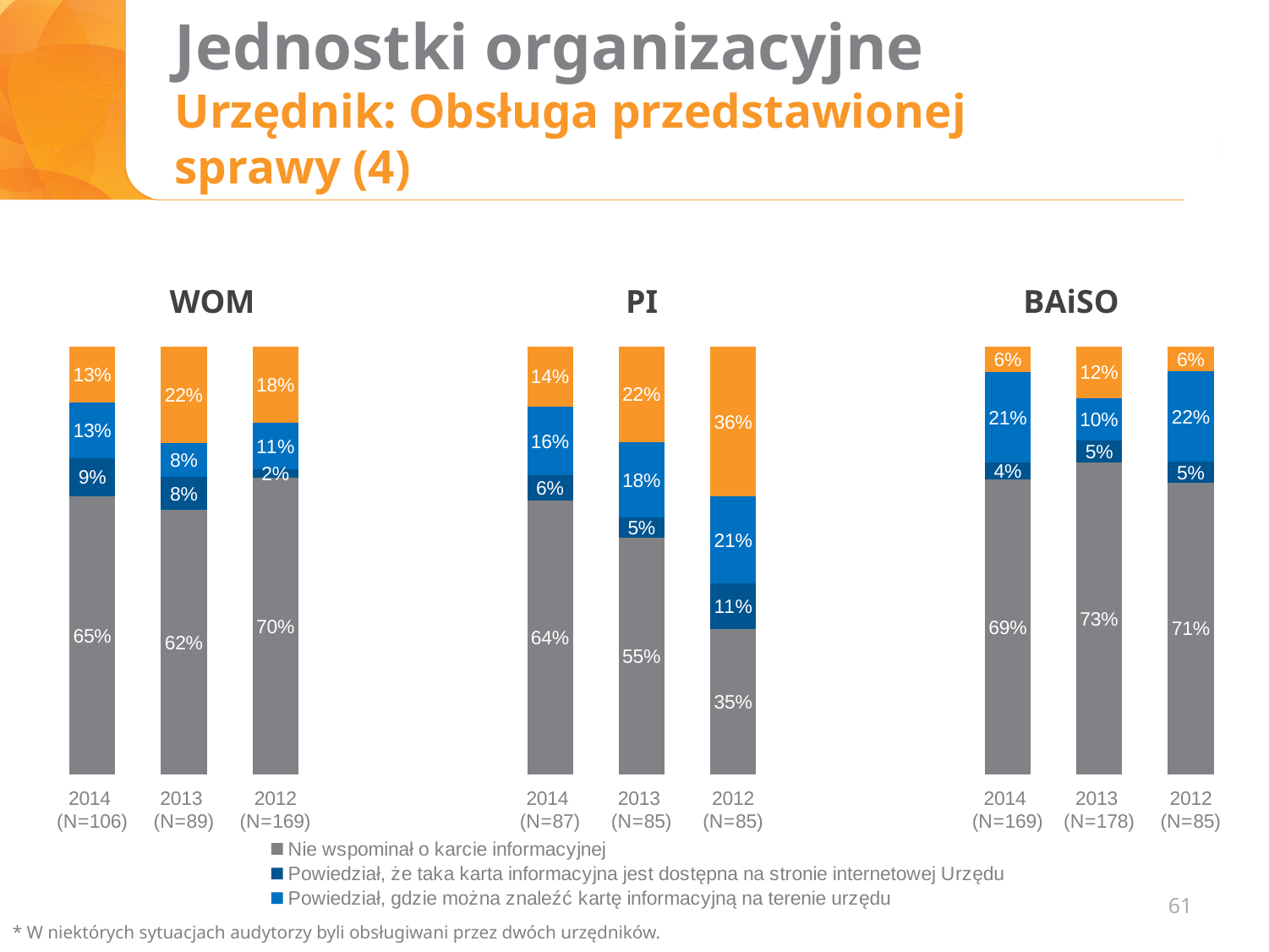
In the PI chart, what is the difference between the "Nie wspominał o karcie informacyjnej" values for 2014 (N=87) and 2013 (N=85)? 9 percentage points How many series does the legend list? 3 In the WOM chart, what is the value for "Powiedział, że taka karta informacyjna jest dostępna na stronie internetowej Urzędu" in 2012 (N=169)? 2% In the WOM chart, what is the value for "Nie wspominał o karcie informacyjnej" in 2014 (N=106)? 65% In the BAiSO chart, which year has the highest value for "Nie wspominał o karcie informacyjnej"? 2013 (N=178) In the WOM chart, which is larger: the "Powiedział, gdzie można znaleźć kartę informacyjną na terenie urzędu" value for 2014 (N=106) or for 2013 (N=89)? 2014 (N=106) How many bars does the PI chart contain? 3 What kind of chart is the WOM chart? Stacked bar chart In the PI chart, what is the value for "Nie wspominał o karcie informacyjnej" in 2012 (N=85)? 35% In the PI chart, what is the total of the 2013 (N=85) bar? 100% In the PI chart, which year has the lowest value for "Nie wspominał o karcie informacyjnej"? 2012 (N=85) In the BAiSO chart, what is the value for "Powiedział, gdzie można znaleźć kartę informacyjną na terenie urzędu" in 2012 (N=85)? 22%